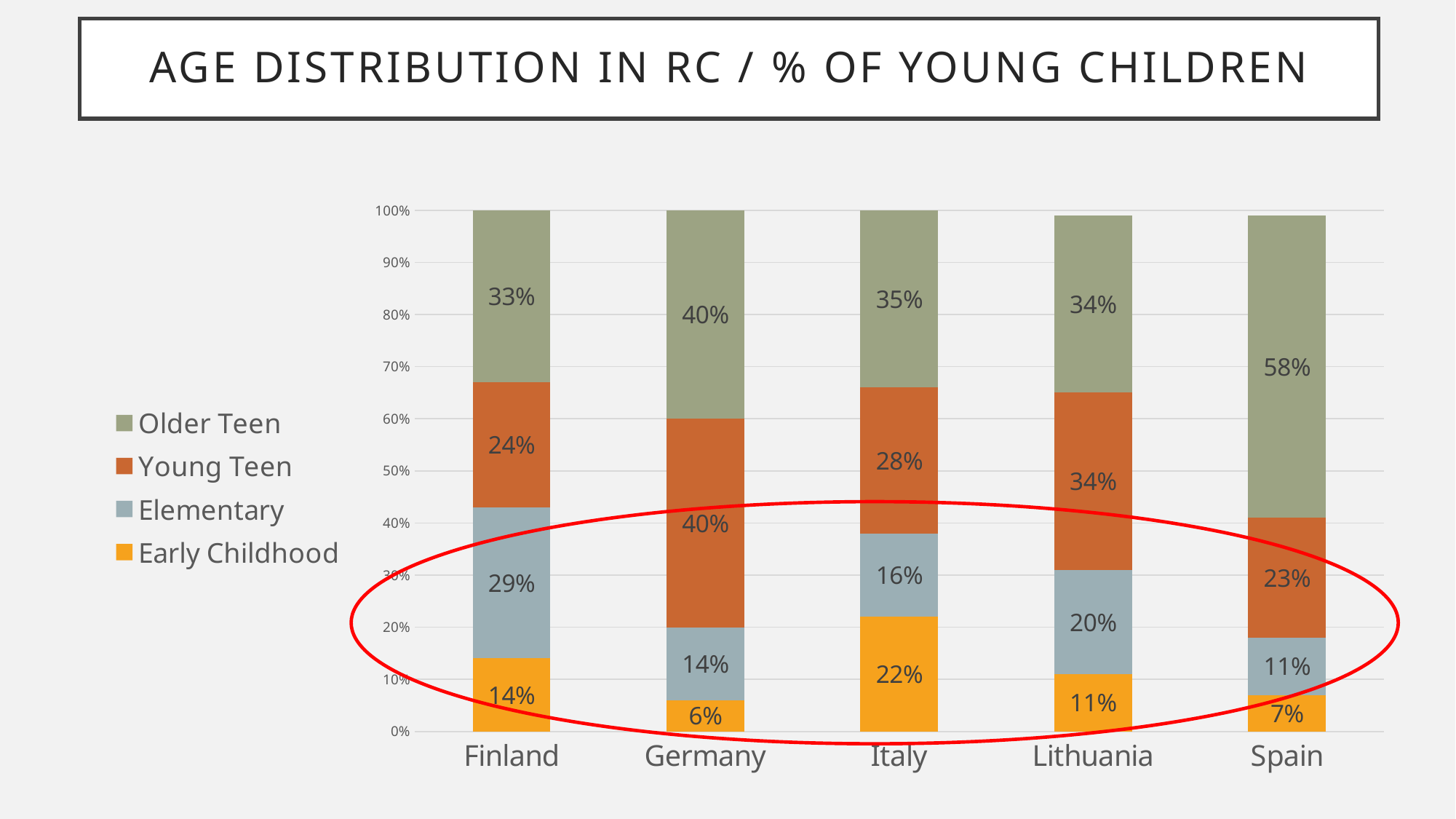
How many series does the legend list? 4 What is the difference between the Elementary percentages for Finland and Spain? 18% What is the Elementary percentage for Lithuania? 20% What kind of chart is shown on the slide? Stacked bar chart What is the Older Teen percentage for Spain? 58% Which country has the highest Early Childhood percentage? Italy Which is larger, the Young Teen percentage for Lithuania or for Italy? Lithuania Which country has the highest Older Teen percentage? Spain Which country has the lowest Early Childhood percentage? Germany What is the Young Teen percentage for Germany? 40% What is the Early Childhood percentage for Italy? 22% How many countries are shown on the x axis? 5